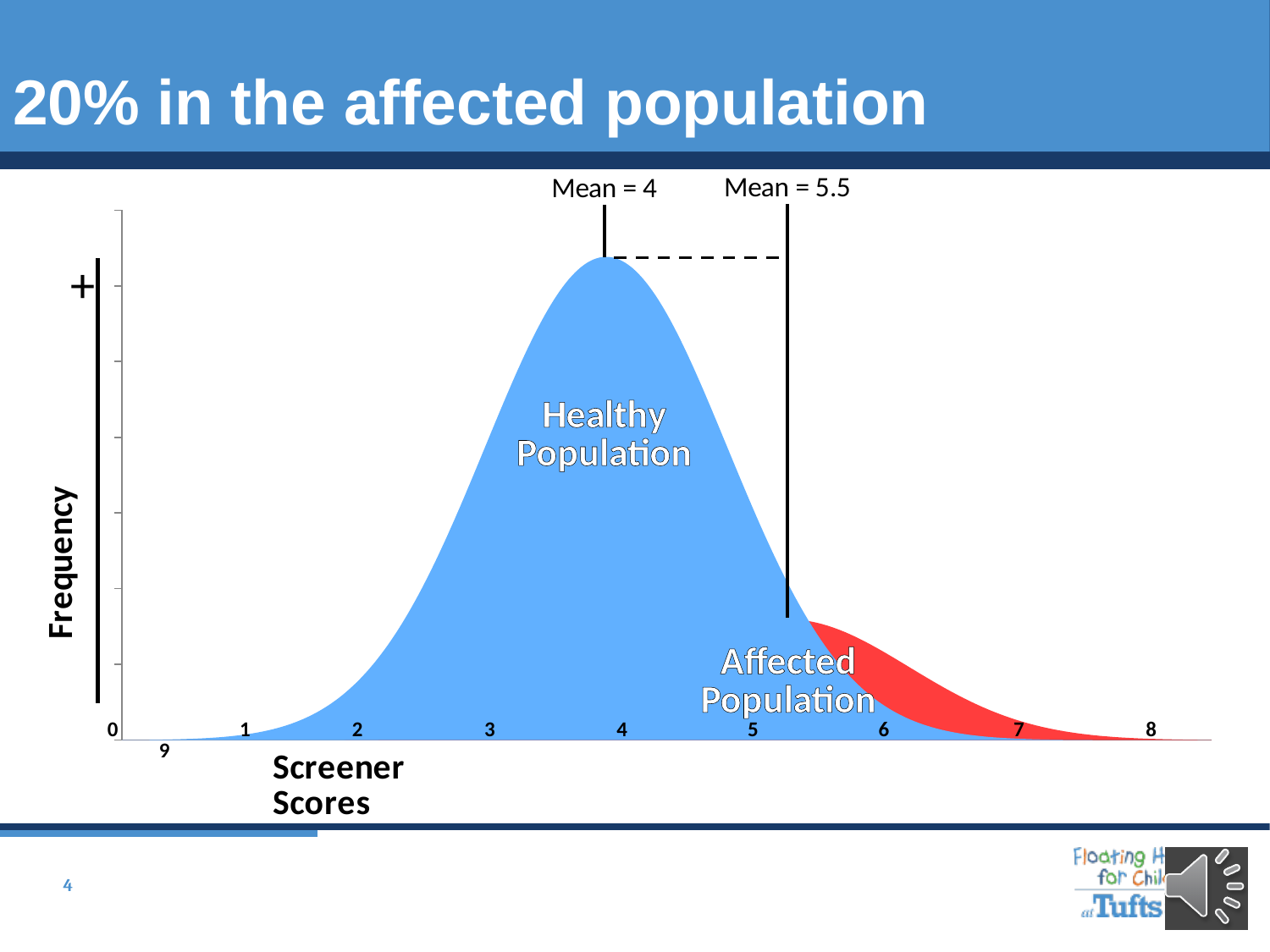
What kind of chart is shown on the slide? area chart What is the difference between the mean of the Affected Population and the mean of the Healthy Population? 1.5 What is the label of the x axis? Screener Scores What is the label of the y axis? Frequency What is the mean screener score of the Healthy Population? 4 How many populations are plotted on the chart? 2 Which population reaches the higher peak frequency? Healthy Population Is the mean of the Affected Population greater or less than 5? greater Which population has the higher mean screener score, the Healthy Population or the Affected Population? Affected Population What is the mean screener score of the Affected Population? 5.5 Which population has the lower peak frequency? Affected Population